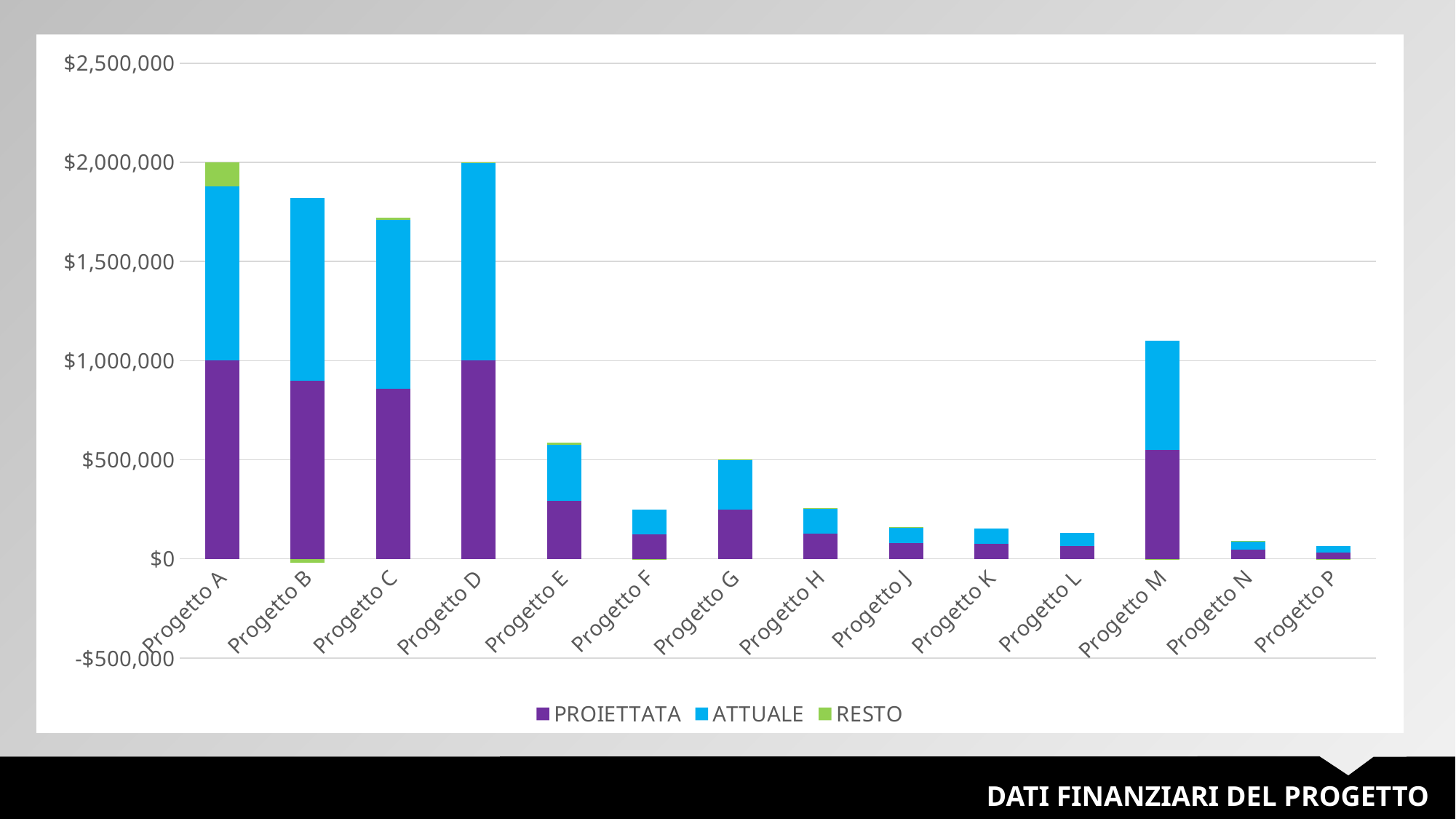
What kind of chart is shown on the slide? Stacked bar chart Which project has the lowest total stacked value? Progetto P Is the total stacked value for Progetto M greater or less than $1,000,000? greater Is the total stacked value for Progetto F greater or less than $500,000? less How many series does the legend list? 3 What is the title shown at the bottom of the slide? DATI FINANZIARI DEL PROGETTO Is the PROIETTATA value for Progetto G greater or less than $500,000? less Which has the larger total stacked value, Progetto B or Progetto C? Progetto B What is the PROIETTATA value for Progetto D? $1,000,000 What are the three series named in the legend? PROIETTATA, ATTUALE, RESTO How many projects (categories) are shown on the x axis? 14